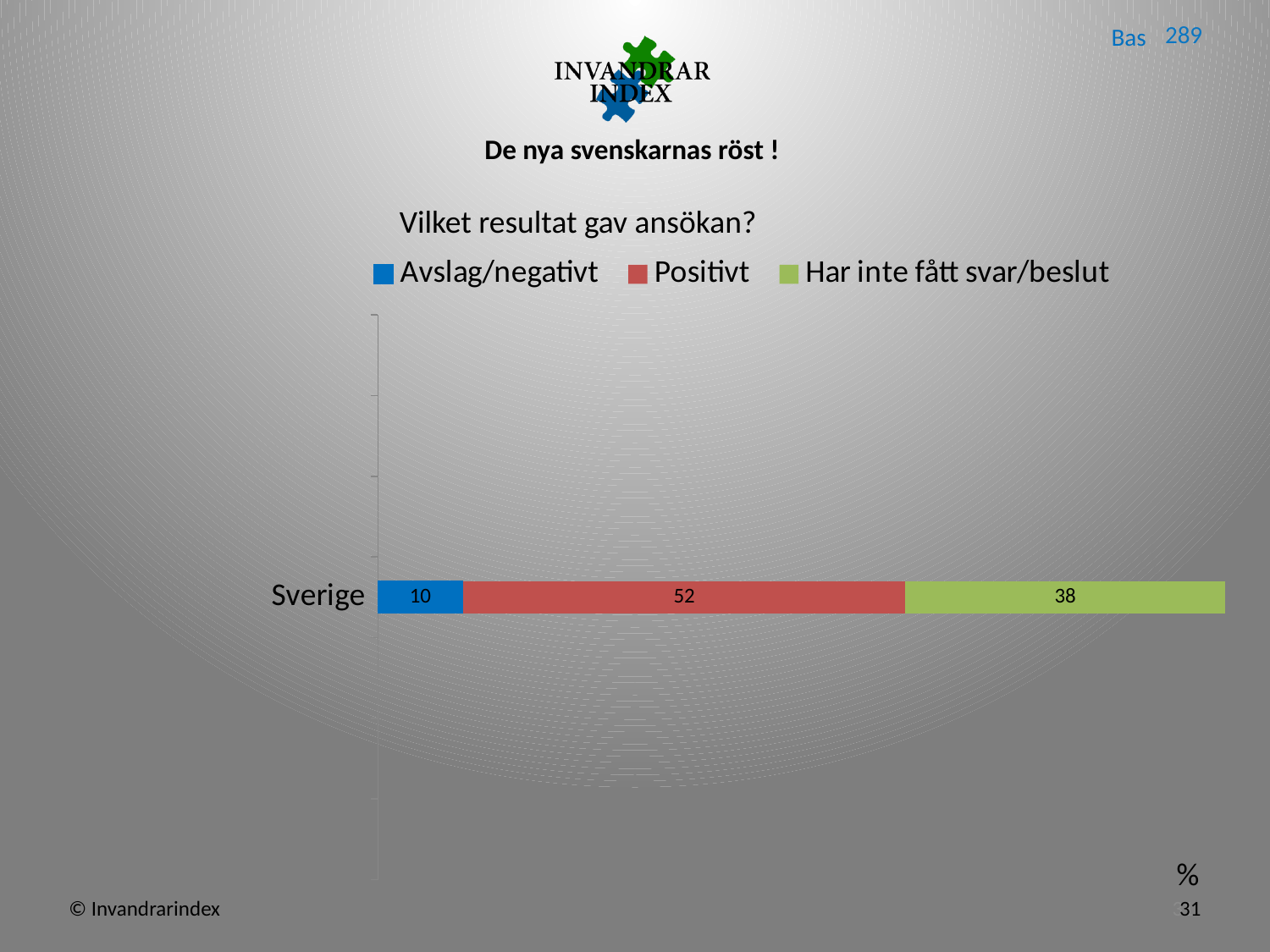
What is the value for Har inte fått svar/beslut for Sverige? 38 What kind of chart is shown on the slide? Stacked bar chart Which is larger for Sverige: Har inte fått svar/beslut or Avslag/negativt? Har inte fått svar/beslut What is the value for Avslag/negativt for Sverige? 10 What is the total of the stacked bar for Sverige? 100 Which series has the lowest value for Sverige? Avslag/negativt What is the difference between the Positivt and Har inte fått svar/beslut values for Sverige? 14 Which series has the highest value for Sverige? Positivt How many series does the legend list? 3 What is the value for Positivt for Sverige? 52 What is the title of the chart? Vilket resultat gav ansökan? How many categories are plotted on the chart? 1